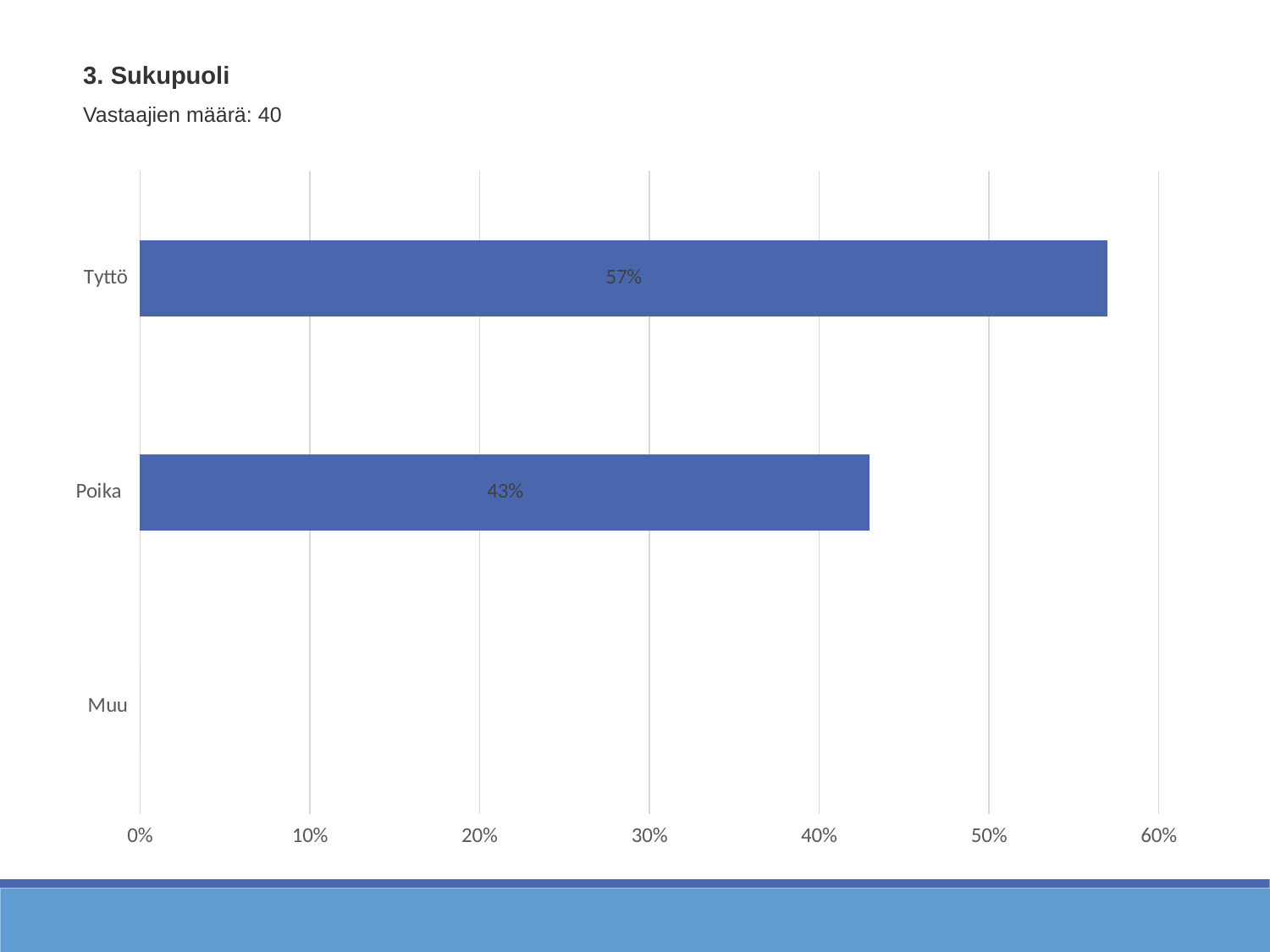
Which category has the lowest value? Muu What is the value for Poika? 43% What is the difference between the values for Tyttö and Poika? 14% What kind of chart is shown on the slide? bar chart Which category has the highest value? Tyttö How many categories are shown on the chart? 3 Is the value for Tyttö greater or less than 50%? greater Which is larger, the value for Tyttö or the value for Poika? Tyttö Is the value for Poika greater or less than 40%? greater What is the title of the chart? 3. Sukupuoli How many respondents (Vastaajien määrä) are stated on the slide? 40 What is the value for Tyttö? 57%